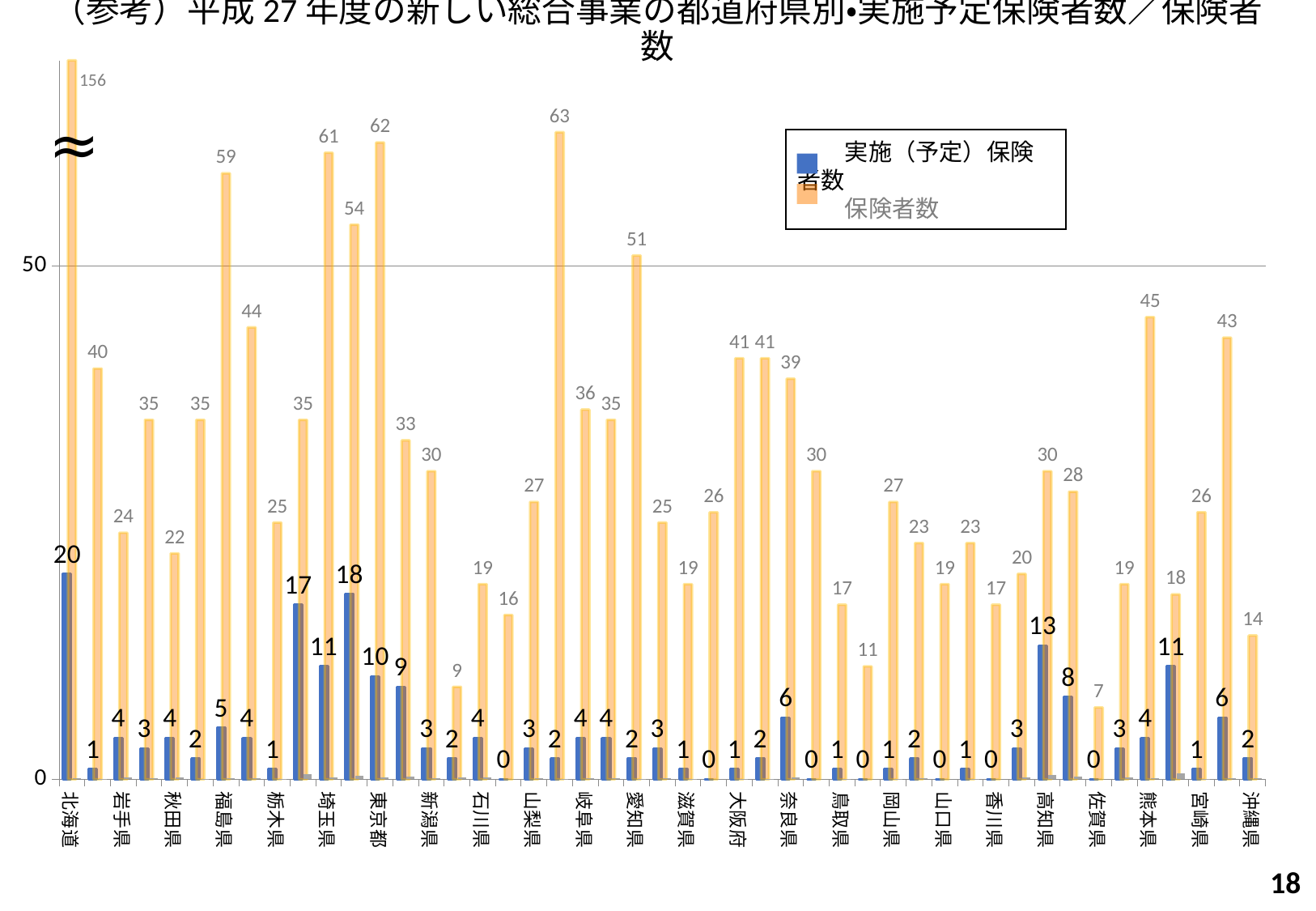
Which is larger, the 保険者数 for 福島県 or for 愛知県? 福島県 What is the 保険者数 value for 東京都? 62 How many series does the legend list? 2 Which colour represents 保険者数 in the chart? orange What is the 実施（予定）保険者数 value for 高知県? 13 What kind of chart is shown on the slide? bar chart Is the 保険者数 value for 埼玉県 greater or less than 50? greater What is the 保険者数 value for 北海道? 156 What is the 実施（予定）保険者数 value for 北海道? 20 Which prefecture has the highest 保険者数? 北海道 What is the 保険者数 value for 沖縄県? 14 What is the difference between 保険者数 and 実施（予定）保険者数 for 熊本県? 41